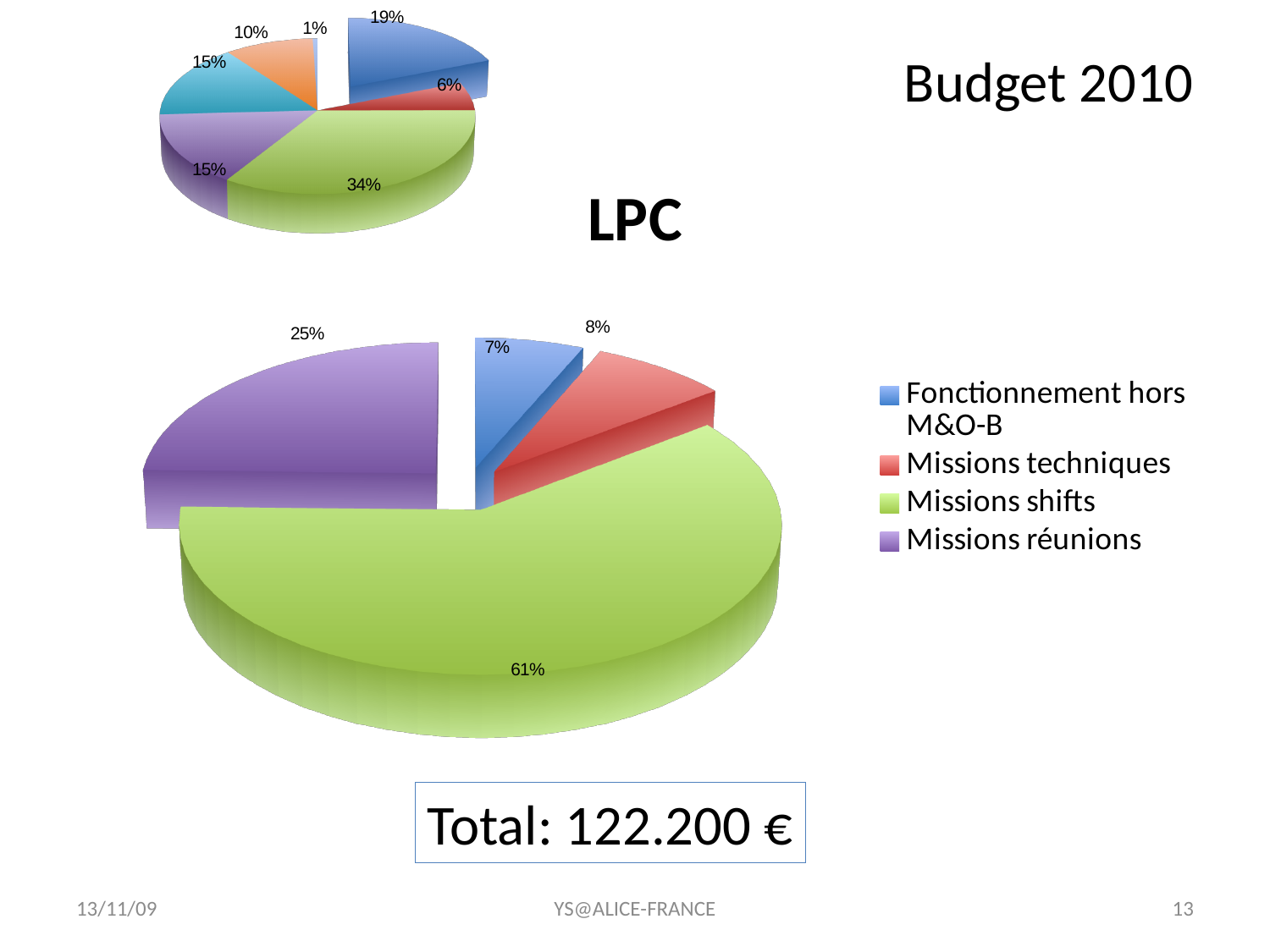
In the small pie chart at the top left of the slide, what is the percentage of the largest slice? 34% In the LPC pie chart, what share does Missions shifts have? 61% In the LPC pie chart, which category has the smallest slice? Fonctionnement hors M&O-B In the LPC pie chart, which is larger: Missions réunions or Missions techniques? Missions réunions In the LPC pie chart, what share does Fonctionnement hors M&O-B have? 7% In the LPC pie chart, what share does Missions techniques have? 8% In the LPC pie chart, what is the difference in percentage points between Missions shifts and Missions réunions? 36 In the LPC pie chart, what share does Missions réunions have? 25% How many entries does the legend of the LPC pie chart list? 4 What kind of chart is the LPC chart? Pie chart How many slices does the small pie chart at the top left of the slide have? 7 In the LPC pie chart, which category has the largest slice? Missions shifts